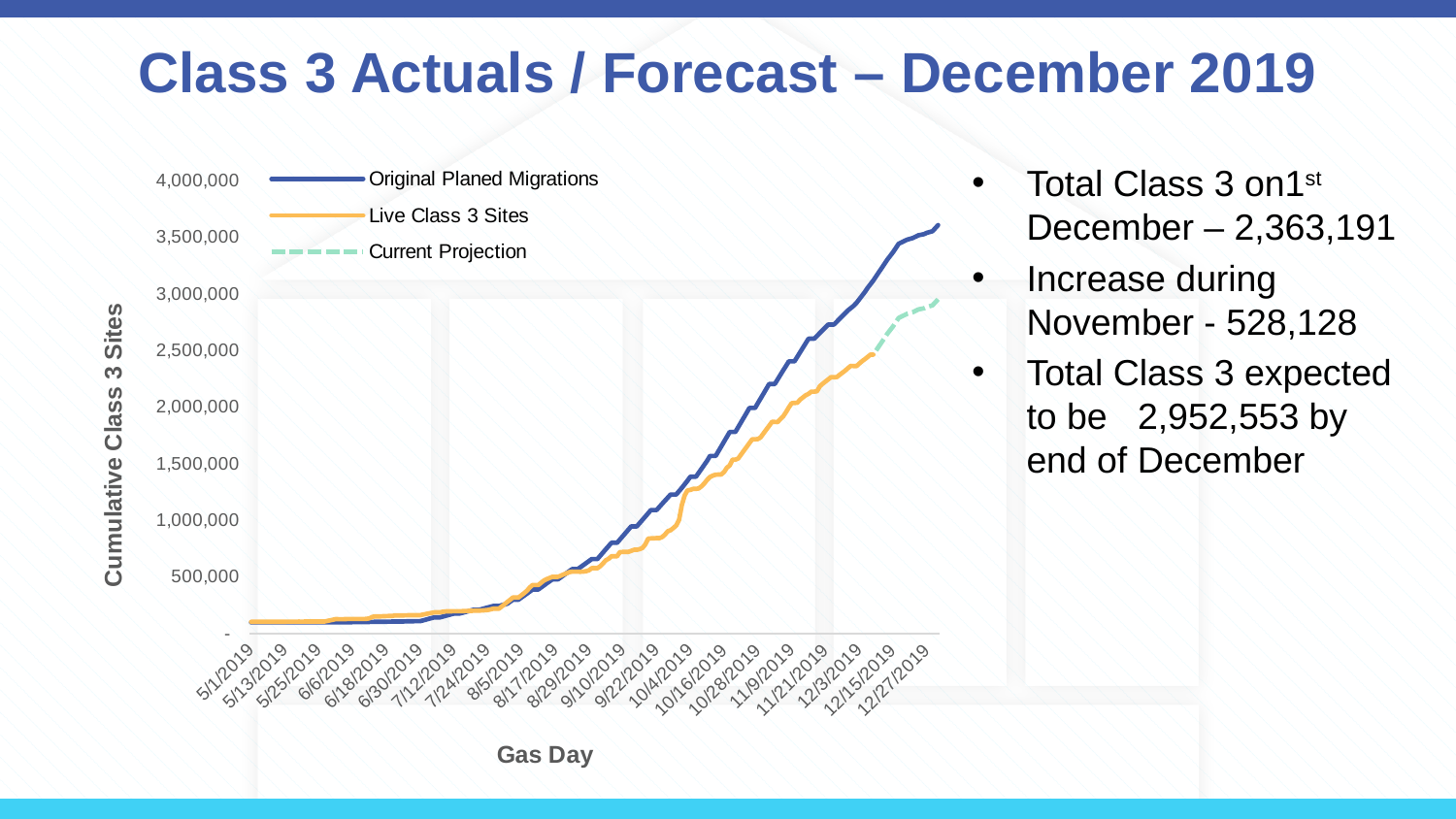
How many date labels are shown on the x axis of the chart? 21 What kind of chart is shown on the slide? Line chart Is the final value of the Current Projection series greater or less than 2,500,000? greater How many series does the chart legend list? 3 Do the values of the Original Planed Migrations series rise or fall along the x axis? Rise What is the title of the vertical axis of the chart? Cumulative Class 3 Sites What is the title of the horizontal axis of the chart? Gas Day At the right end of the chart, which is larger: Original Planed Migrations or Live Class 3 Sites? Original Planed Migrations Is the value of the Live Class 3 Sites series on 7/12/2019 greater or less than 500,000? less Is the final value of the Live Class 3 Sites series greater or less than 3,000,000? less Which series reaches the highest value on the chart? Original Planed Migrations